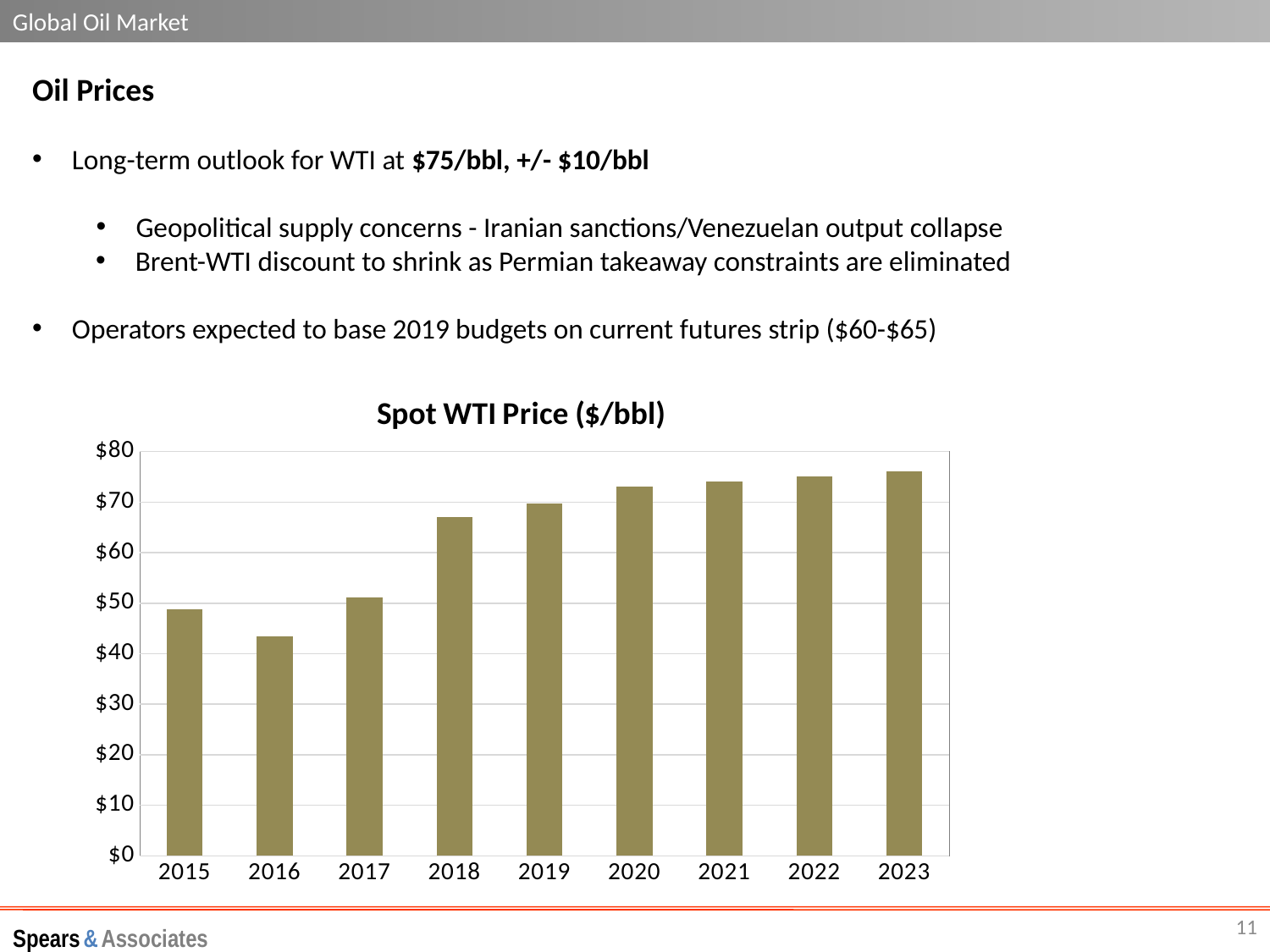
Do the values rise or fall from 2016 to 2023? rise Which is larger, the value for 2018 or the value for 2016? 2018 What is the highest value shown on the y axis of the chart? $80 How many years are shown on the x axis of the chart? 9 Which is larger, the value for 2015 or the value for 2016? 2015 Is the value for 2023 greater or less than $70? greater What is the title of the chart? Spot WTI Price ($/bbl) What type of chart is shown on the slide? bar chart Which year has the lowest spot WTI price in the chart? 2016 Is the value for 2016 greater or less than $50? less Is the value for 2023 greater or less than $80? less